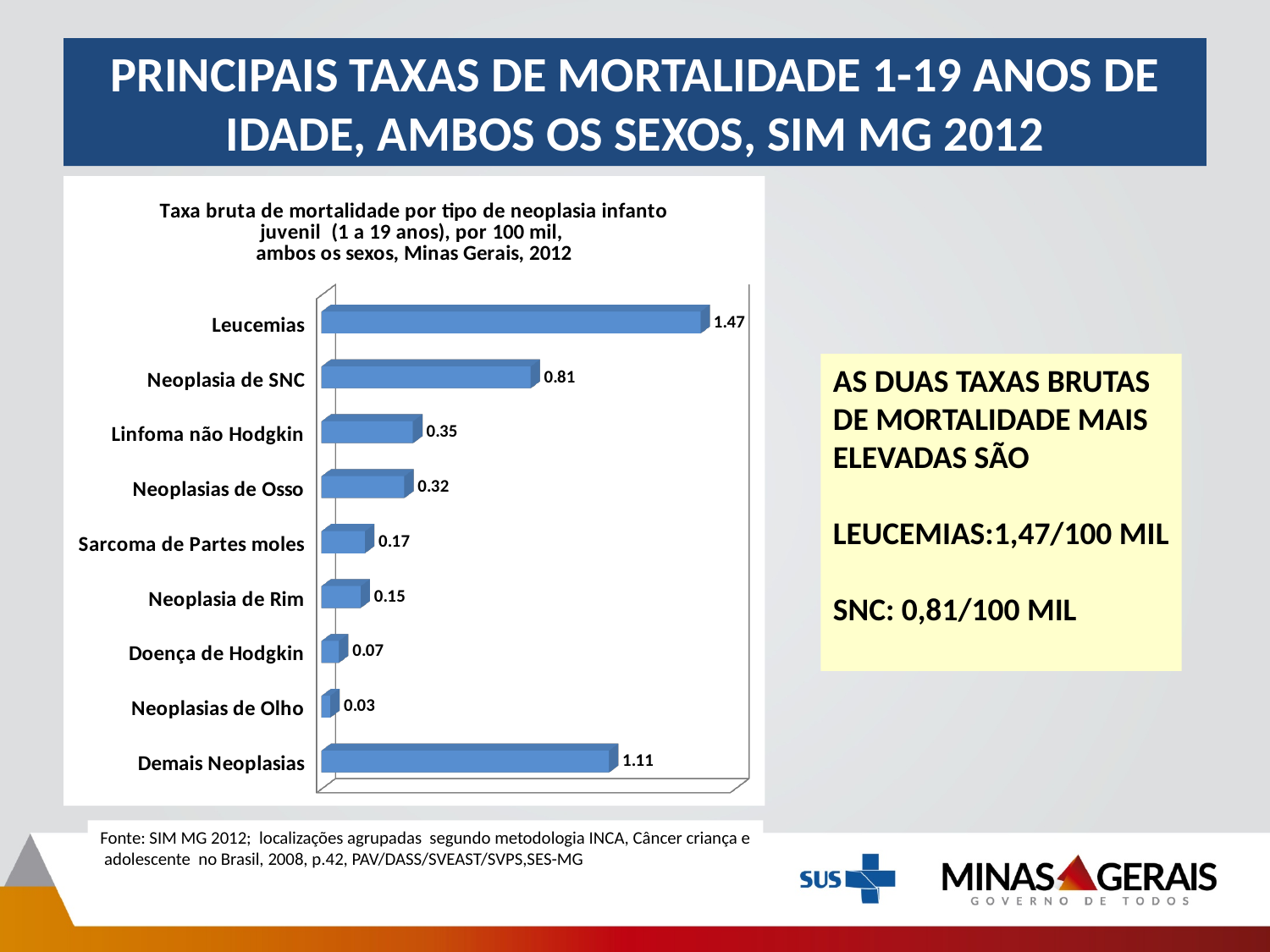
What is the difference between the values for Sarcoma de Partes moles and Neoplasia de Rim? 0.02 Which category has the highest value? Leucemias How many categories are shown in the chart? 9 What is the difference between the values for Leucemias and Neoplasia de SNC? 0.66 What is the value shown for Neoplasia de SNC? 0.81 What is the title of the chart? Taxa bruta de mortalidade por tipo de neoplasia infanto juvenil (1 a 19 anos), por 100 mil, ambos os sexos, Minas Gerais, 2012 Which is larger, the value for Linfoma não Hodgkin or the value for Neoplasias de Osso? Linfoma não Hodgkin Which category has the lowest value? Neoplasias de Olho What is the value shown for Demais Neoplasias? 1.11 What is the mortality rate for Leucemias? 1.47 What is the value shown for Neoplasias de Olho? 0.03 What kind of chart is shown on the slide? Bar chart